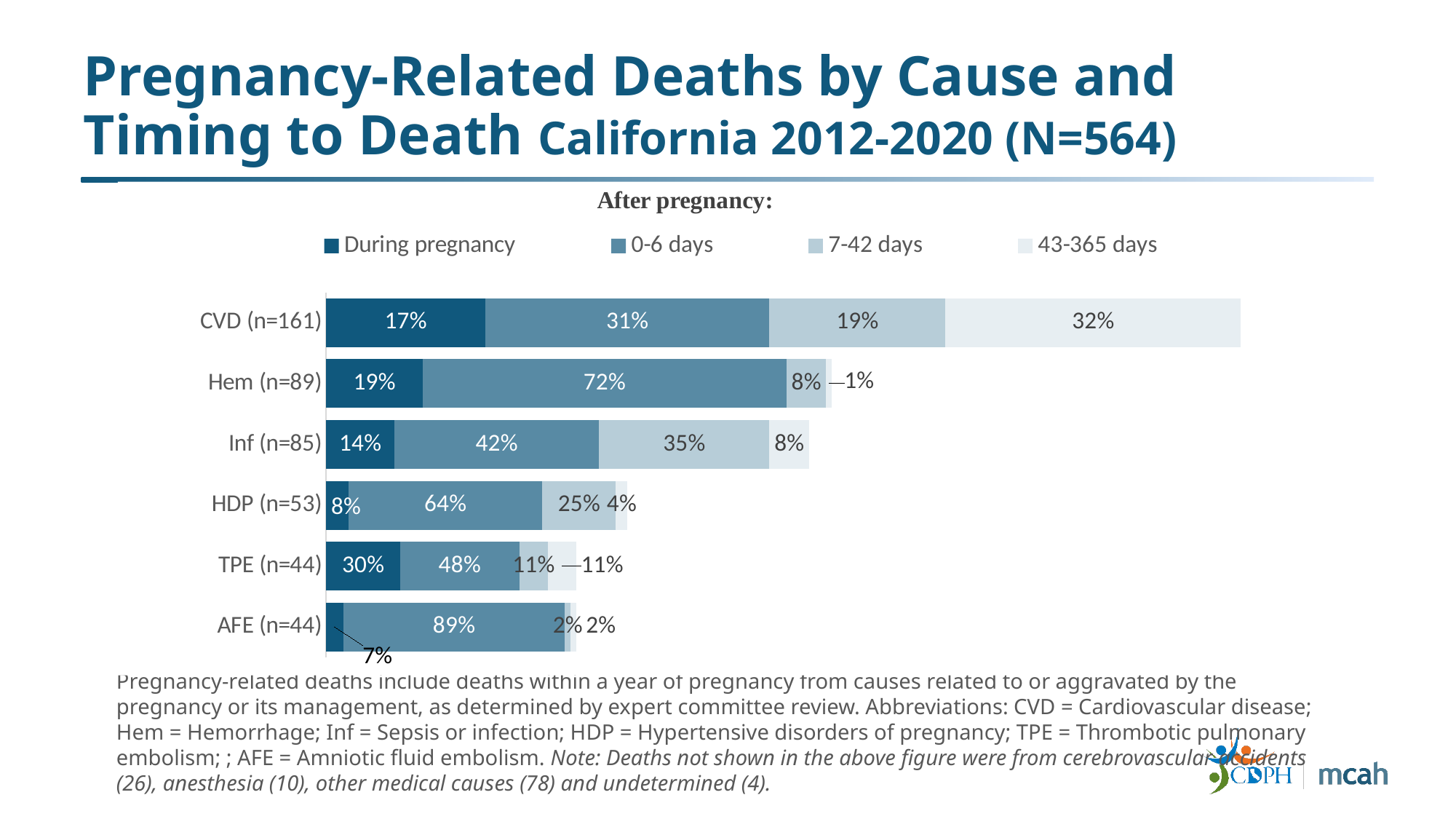
What percentage of CVD deaths occurred 43-365 days after pregnancy? 32% What percentage of Inf (n=85) deaths occurred 7-42 days after pregnancy? 35% What kind of chart is shown on the slide? Stacked bar chart How many series does the legend list? 4 Which cause has the lowest percentage of deaths during pregnancy? AFE (n=44) Which cause has the highest percentage of deaths in the 0-6 days category? AFE (n=44) What percentage of TPE (n=44) deaths occurred during pregnancy? 30% How many cause categories are plotted on the chart? 6 Which legend entry is shown in the darkest blue? During pregnancy What percentage of Hem (n=89) deaths occurred 0-6 days after pregnancy? 72% What is the difference between the 0-6 days percentage for HDP and the 0-6 days percentage for CVD? 33% Which is larger: the during-pregnancy percentage for Hem or for Inf? Hem